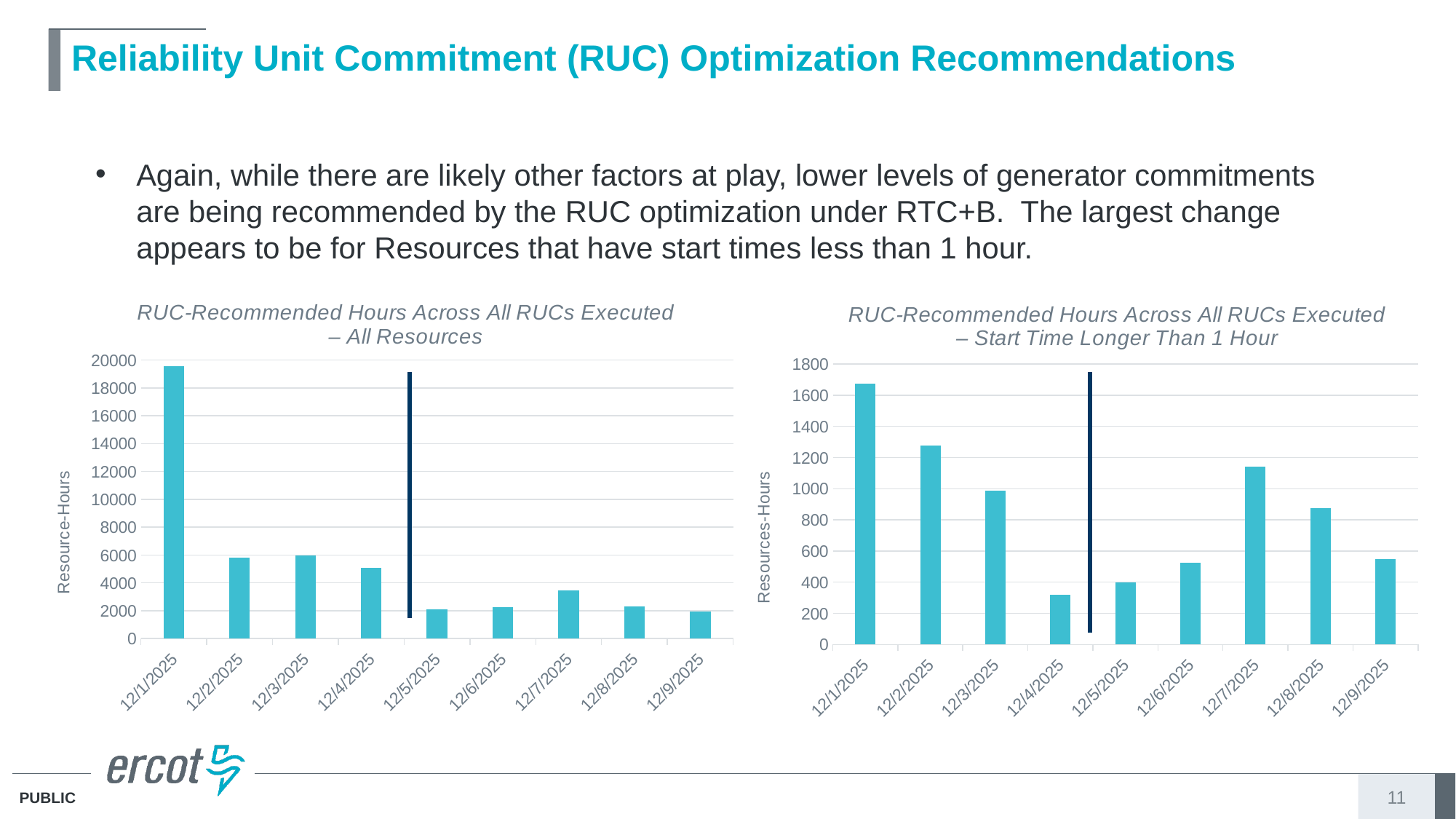
How many dates are shown on the x axis of the 'All Resources' chart on the left? 9 In the 'Start Time Longer Than 1 Hour' chart on the right, which date has the highest value? 12/1/2025 In the 'All Resources' chart on the left, which is larger, the value for 12/2/2025 or the value for 12/7/2025? 12/2/2025 In the 'All Resources' chart on the left, which date has the highest value? 12/1/2025 In the 'All Resources' chart on the left, is the value for 12/1/2025 greater or less than 18000? greater In the 'Start Time Longer Than 1 Hour' chart on the right, do the values rise or fall from 12/4/2025 to 12/7/2025? Rise What is the y-axis label of the 'Start Time Longer Than 1 Hour' chart on the right? Resources-Hours In the 'Start Time Longer Than 1 Hour' chart on the right, is the value for 12/7/2025 greater or less than 1000? greater In the 'Start Time Longer Than 1 Hour' chart on the right, is the value for 12/4/2025 greater or less than 400? less In the 'Start Time Longer Than 1 Hour' chart on the right, which date has the lowest value? 12/4/2025 What kind of chart is the 'RUC-Recommended Hours Across All RUCs Executed – All Resources' chart? Bar chart